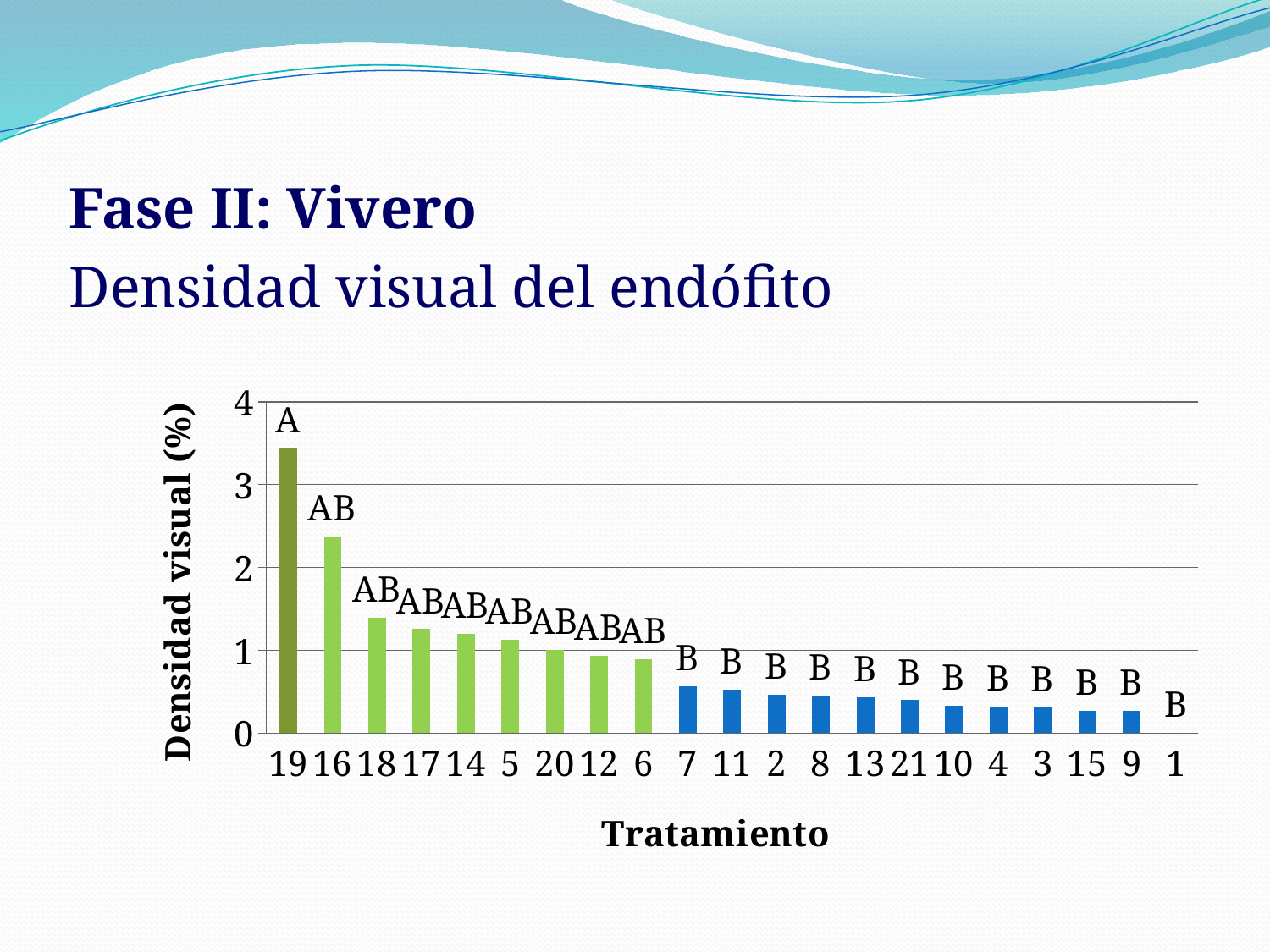
Do the values rise or fall from left to right along the x axis? fall Is the value for treatment 16 greater or less than 2? greater Which treatment has the lowest visual density? 1 Which has a larger visual density, treatment 19 or treatment 16? 19 What kind of chart is shown on the slide? bar chart Is the value for treatment 19 greater or less than 3? greater What is the title of the y axis? Densidad visual (%) Is the value for treatment 18 greater or less than 1? greater Which treatment has the highest visual density? 19 How many treatments (categories) are shown on the x axis? 21 What statistical group letter is printed above the bar for treatment 19? A